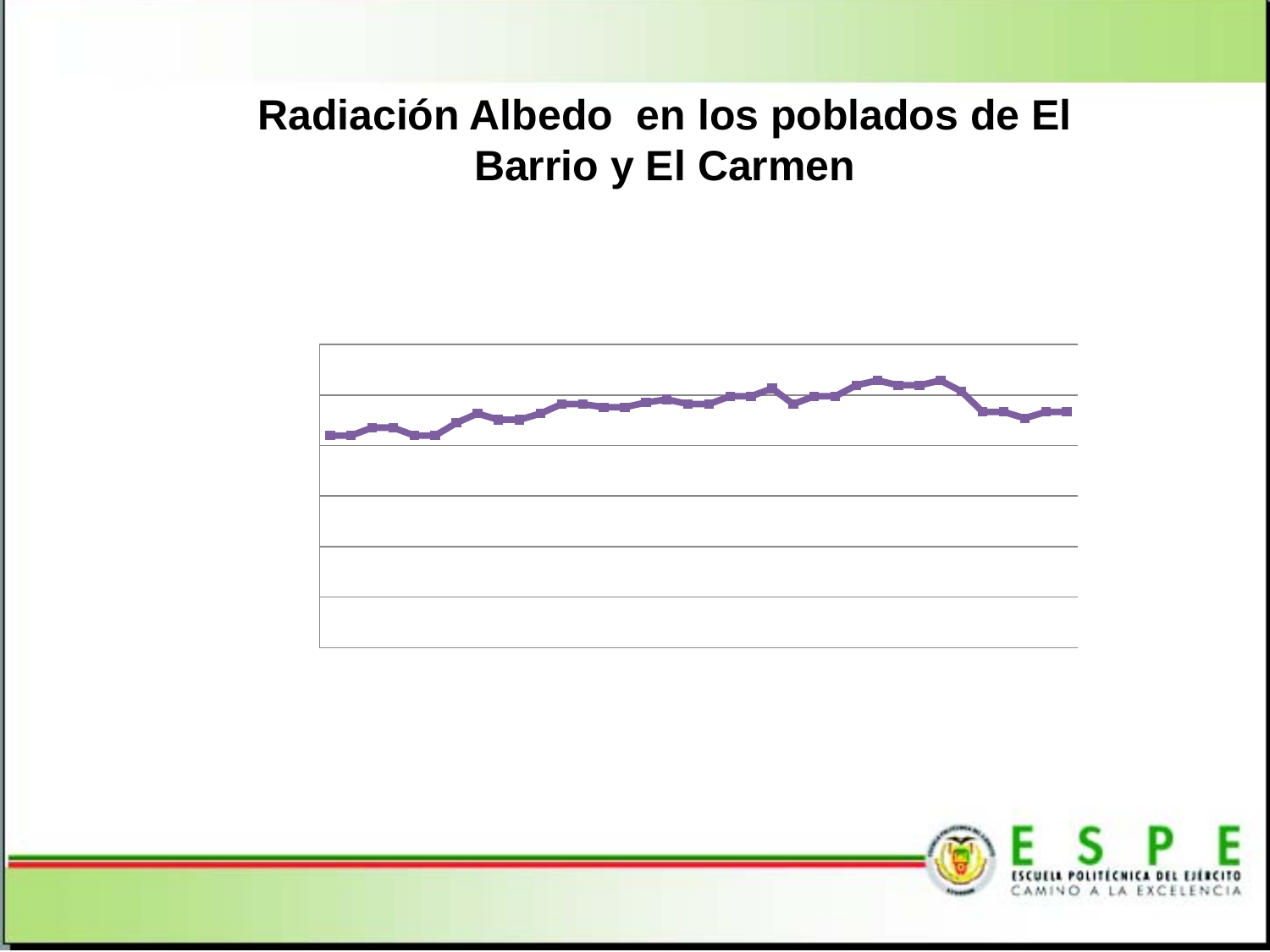
How many lines (data series) are plotted on the chart? 1 What kind of chart is shown on the slide? line chart What colour is the plotted line on the chart? purple Do the plotted values generally rise or fall from left to right along the x axis? rise What is the title shown above the chart on the slide? Radiación Albedo en los poblados de El Barrio y El Carmen